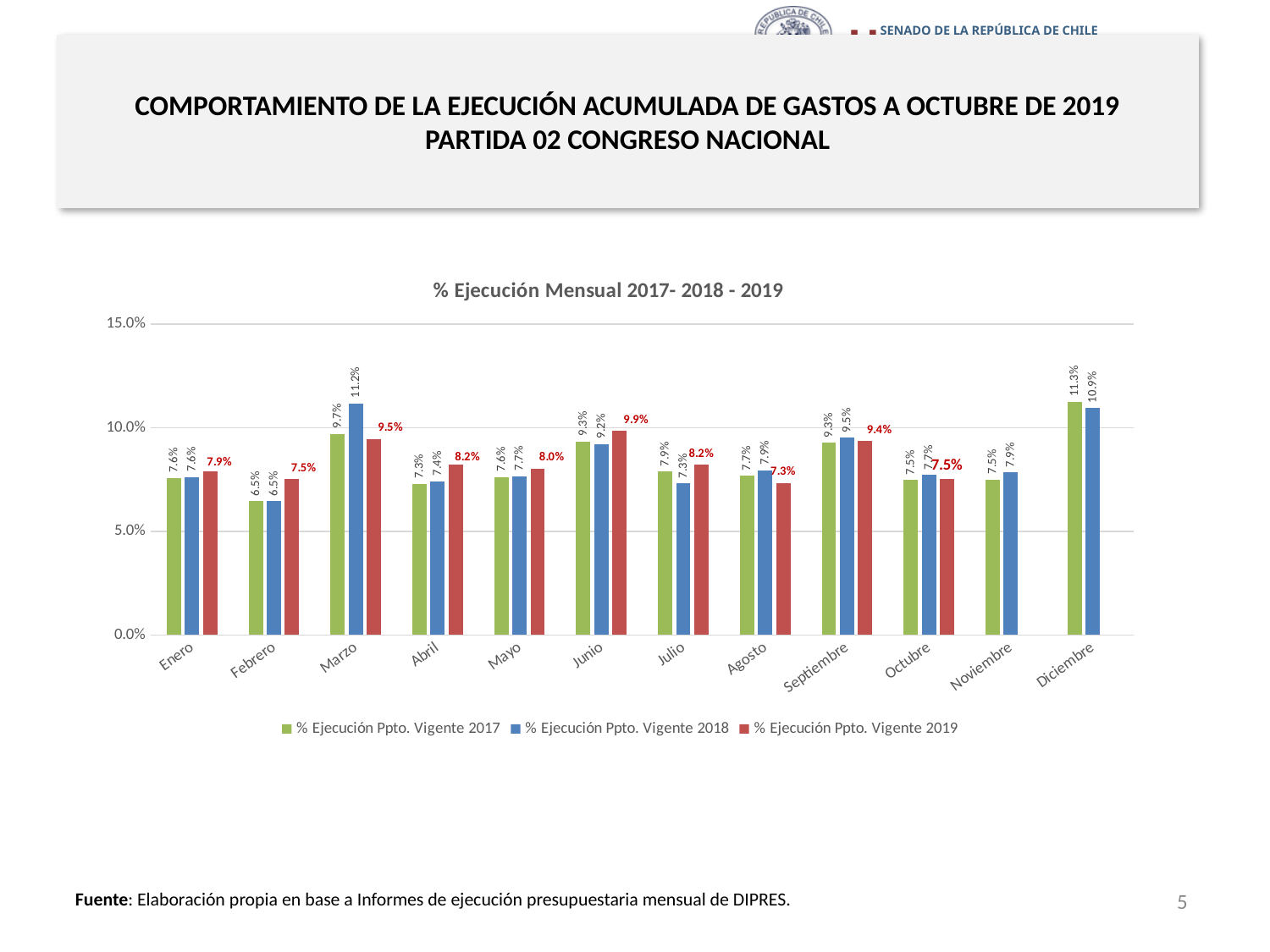
Is the value for % Ejecución Ppto. Vigente 2017 in Diciembre greater or less than 10.0%? greater How many months are shown on the x axis? 12 What is the difference between the 2018 and 2017 values in Marzo? 1.5 percentage points What is the value for % Ejecución Ppto. Vigente 2018 in Diciembre? 10.9% Which month has the highest value for % Ejecución Ppto. Vigente 2019? Junio Which month has the lowest value for % Ejecución Ppto. Vigente 2019? Agosto What is the value for % Ejecución Ppto. Vigente 2019 in Junio? 9.9% What is the title of the chart? % Ejecución Mensual 2017- 2018 - 2019 In Julio, which is larger: the 2017 value or the 2018 value? 2017 (7.9%) What is the value for % Ejecución Ppto. Vigente 2018 in Marzo? 11.2% What kind of chart is shown on the slide? Bar chart How many series does the legend list? 3